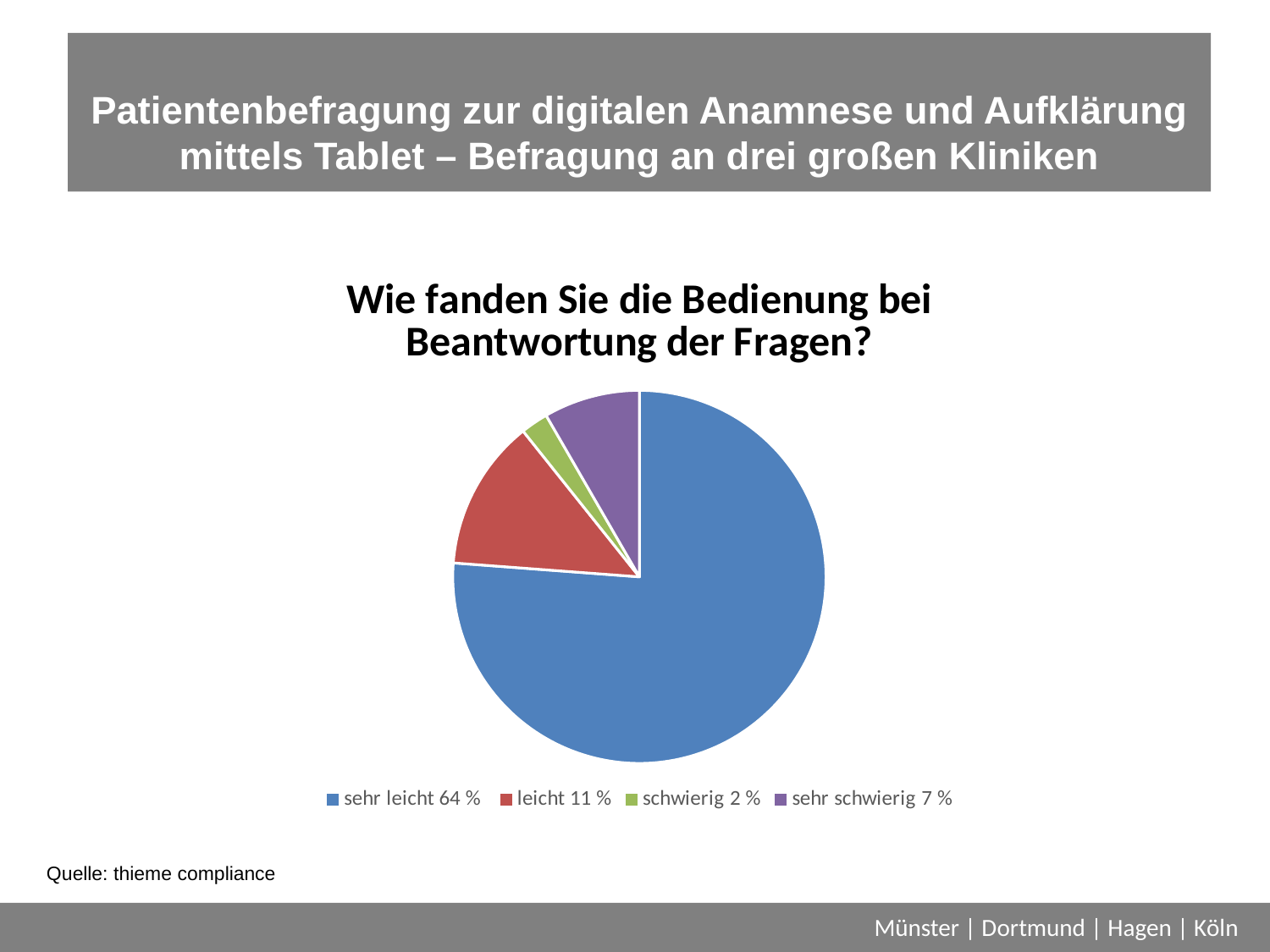
What percentage is given for "sehr leicht" in the legend? 64 % Which category has the largest slice of the pie? sehr leicht Which is larger, the value for "leicht" or the value for "sehr schwierig"? leicht What percentage is given for "sehr schwierig" in the legend? 7 % What kind of chart is shown on the slide? pie chart What is the difference between the percentages for "sehr leicht" and "leicht"? 53 % Which category has the smallest slice of the pie? schwierig How many categories does the pie chart show? 4 What colour is the "sehr leicht" slice? blue What is the title of the pie chart? Wie fanden Sie die Bedienung bei Beantwortung der Fragen? What percentage is given for "schwierig" in the legend? 2 % What percentage is given for "leicht" in the legend? 11 %